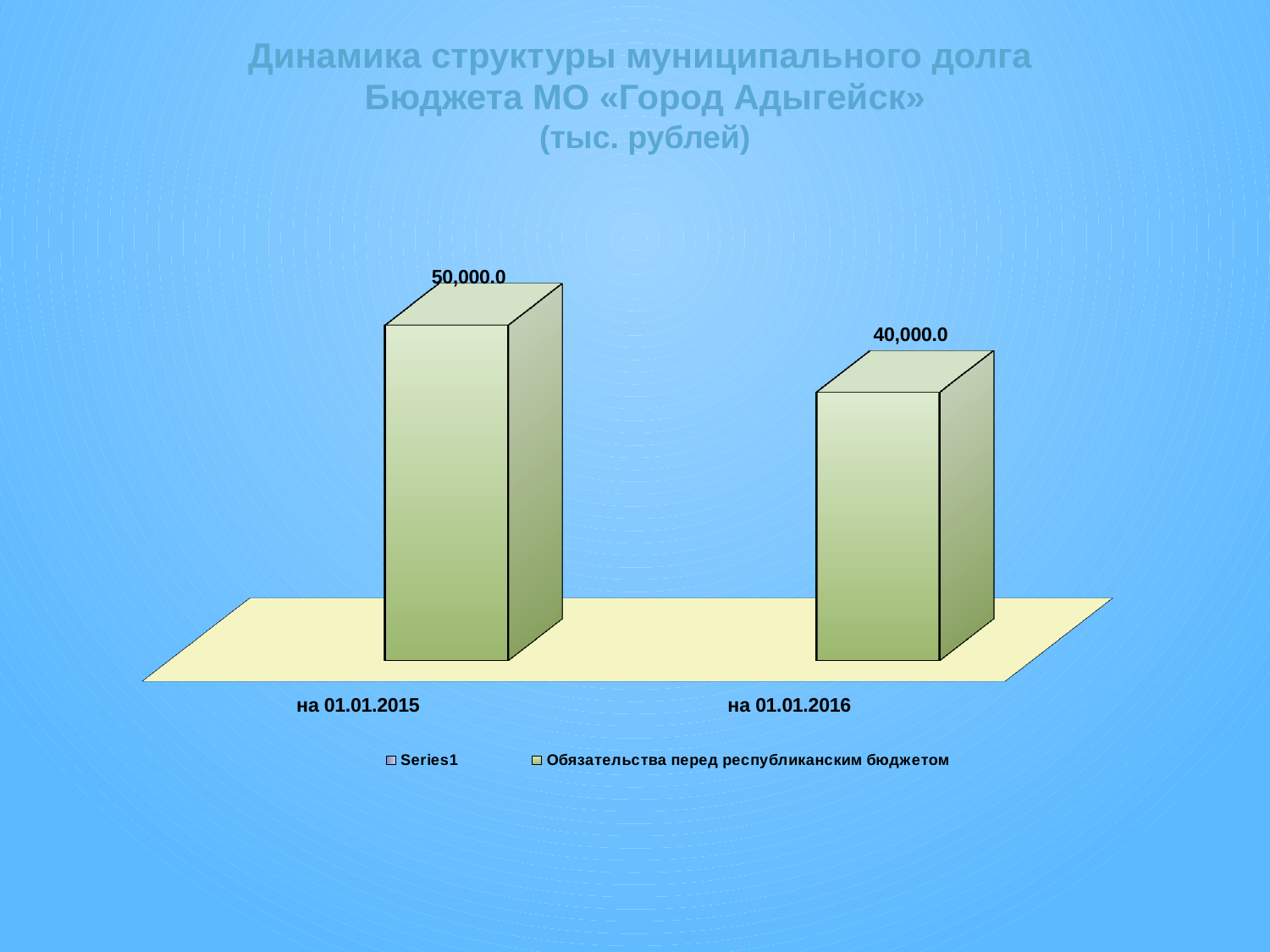
What is the value for на 01.01.2015? 50,000.0 What kind of chart is shown on the slide? bar chart Which category has the lowest value? на 01.01.2016 What unit is given in the chart title? тыс. рублей Do the values rise or fall from на 01.01.2015 to на 01.01.2016? fall What is the second legend entry? Обязательства перед республиканским бюджетом Which is larger, the value for на 01.01.2015 or the value for на 01.01.2016? на 01.01.2015 What is the difference between the values for на 01.01.2015 and на 01.01.2016? 10,000.0 How many entries does the legend list? 2 Which category has the highest value? на 01.01.2015 What is the value for на 01.01.2016? 40,000.0 How many categories are shown on the x axis? 2